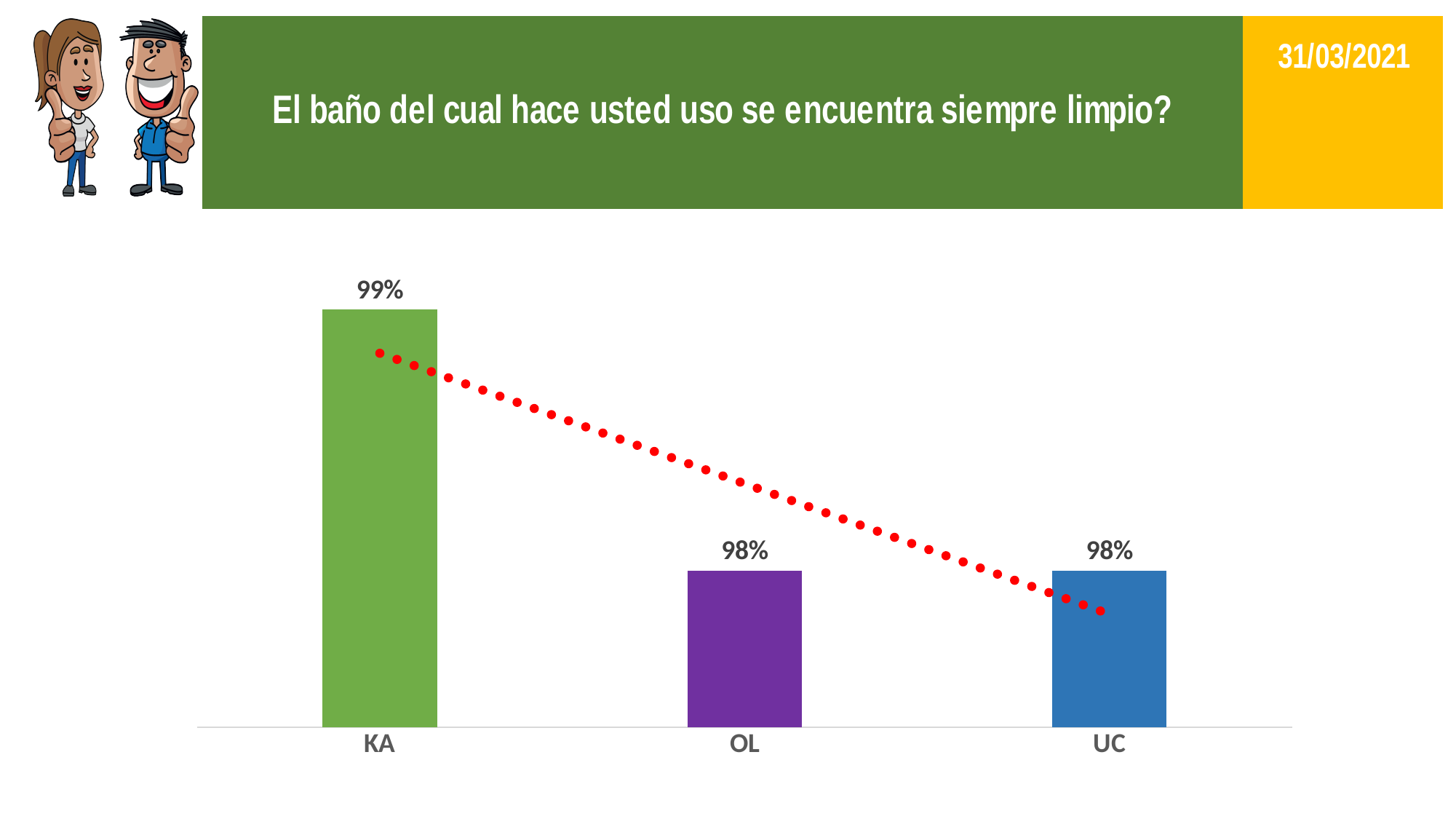
What colour is the bar for OL? purple How many categories are shown on the x axis? 3 What is the difference between the values for KA and OL? 1% What is the value for UC? 98% What is the value for KA? 99% What kind of chart is shown on the slide? bar chart What is the value for OL? 98% Which category has the highest value? KA What date is shown in the top right corner of the slide? 31/03/2021 Do the values rise or fall from KA to UC along the x axis? fall Which is larger, the value for KA or the value for OL? KA What is the difference between the values for KA and UC? 1%